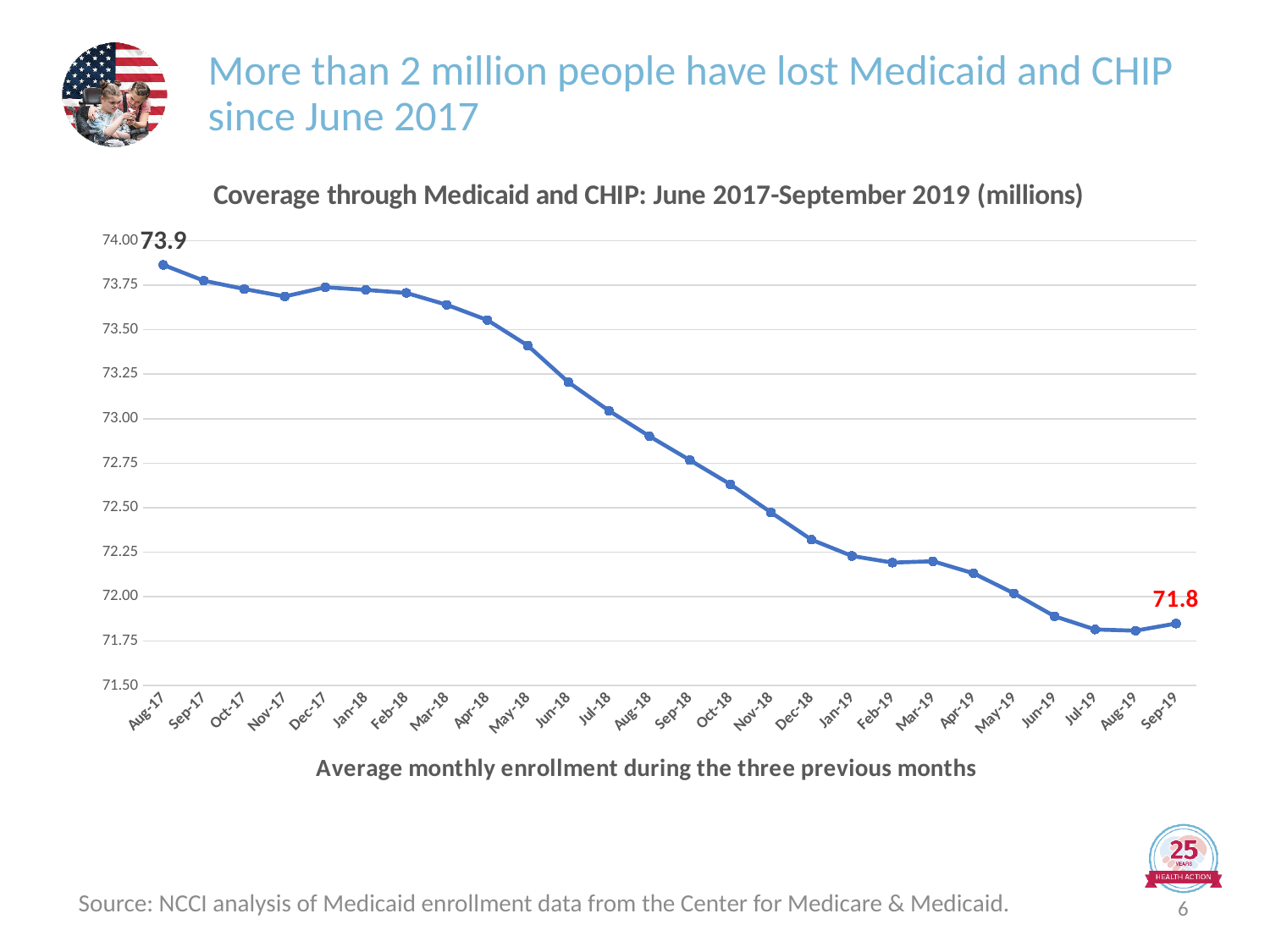
Is the value for Jun-19 greater or less than 72.00? less Is the value for Mar-18 greater or less than 73.50? greater Do the values rise or fall from Aug-17 to Sep-19? fall What kind of chart is shown? line chart Which month has the highest value? Aug-17 Which is larger, the value for Aug-17 or the value for Sep-19? Aug-17 What is the difference between the Aug-17 value and the Sep-19 value? 2.1 Is the value for Jun-18 greater or less than 73.00? greater What is the value for Aug-17? 73.9 How many data points are plotted on the chart? 26 What is the value for Sep-19? 71.8